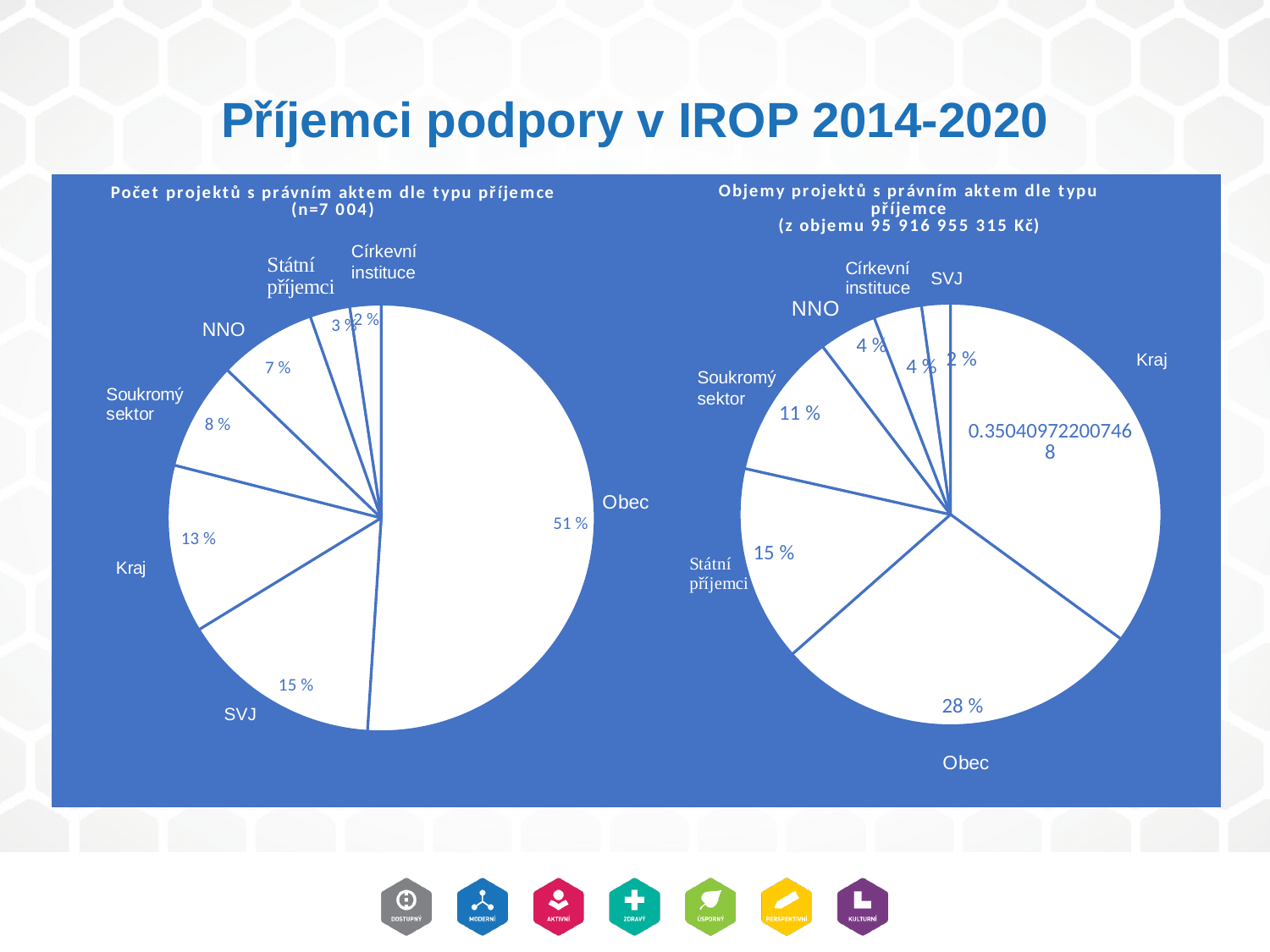
In the left chart (Počet projektů s právním aktem dle typu příjemce), which recipient type has the smallest share? Církevní instituce In the left chart (Počet projektů s právním aktem dle typu příjemce), what share of projects is for SVJ? 15 % In the left chart (Počet projektů s právním aktem dle typu příjemce), how many recipient types are shown? 7 In the right chart (Objemy projektů s právním aktem dle typu příjemce), which is larger: the share for Soukromý sektor or the share for NNO? Soukromý sektor What type of chart is used on this slide? Pie chart In the right chart (Objemy projektů s právním aktem dle typu příjemce), what share of the volume is for Obec? 28 % In the left chart (Počet projektů s právním aktem dle typu příjemce), which recipient type has the largest share? Obec In the right chart (Objemy projektů s právním aktem dle typu příjemce), which recipient type has the largest share? Kraj According to the right chart's title, what total volume in Kč do the shares refer to? 95 916 955 315 Kč In the right chart (Objemy projektů s právním aktem dle typu příjemce), what share of the volume is for Státní příjemci? 15 % In the left chart (Počet projektů s právním aktem dle typu příjemce), what is the difference between the shares of Kraj and Soukromý sektor? 5 % In the left chart (Počet projektů s právním aktem dle typu příjemce), what share of projects is for Obec? 51 %